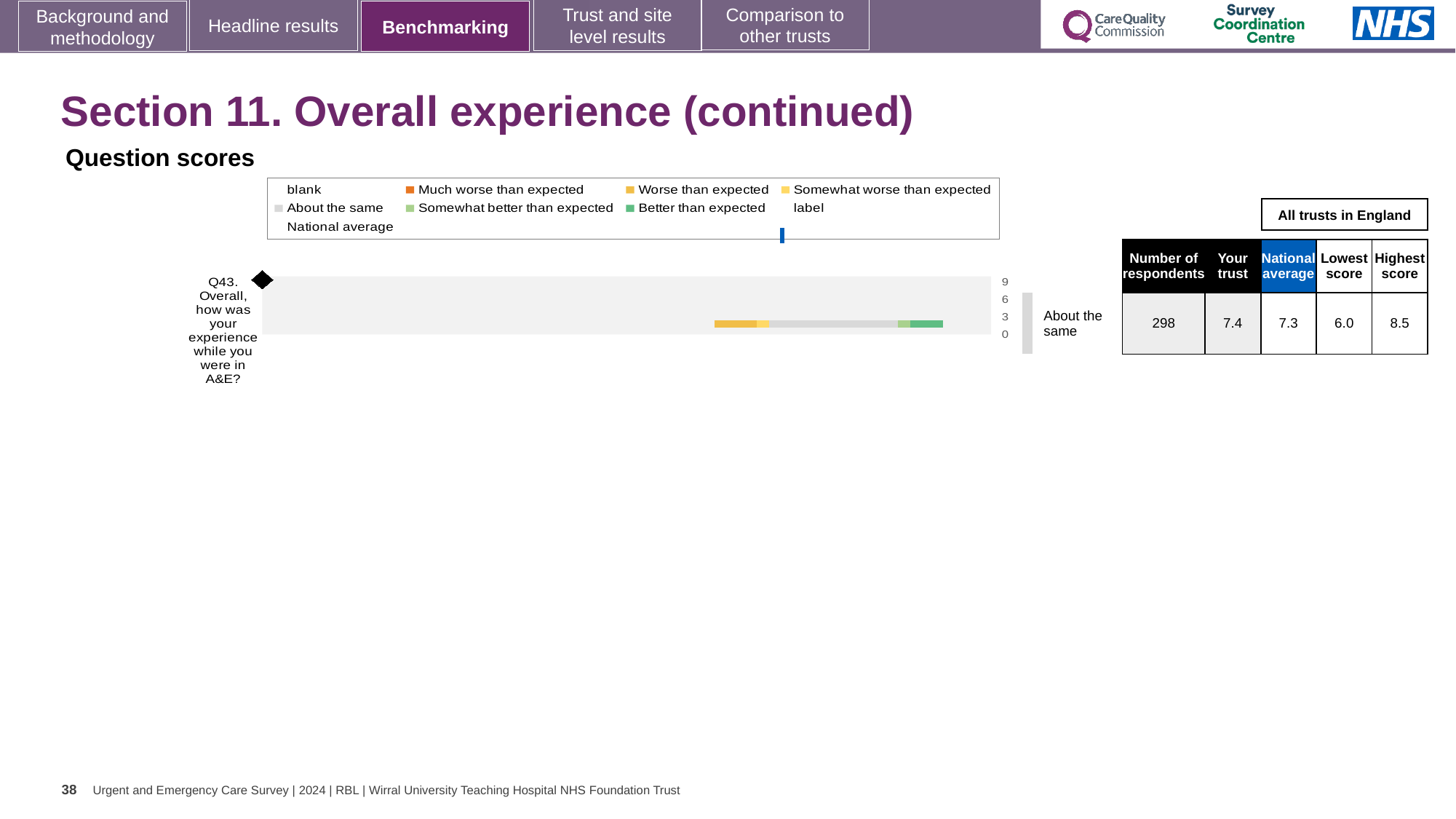
Which benchmarking category is shown next to the bar for Q43? About the same For Q43, which is larger: the 'Your trust' score or the national average? Your trust What is the national average score for Q43? 7.3 How many questions are plotted in the Question scores chart? 1 What is the title of the chart on the slide? Question scores What kind of chart is used to show the Q43 question score? bar chart What is the number of respondents for Q43? 298 For Q43, what is the difference between the highest score and the lowest score among all trusts in England? 2.5 What is the highest score among all trusts in England for Q43? 8.5 Which question is plotted in the Question scores chart? Q43. Overall, how was your experience while you were in A&E? What is the lowest score among all trusts in England for Q43? 6.0 What is the 'Your trust' score for Q43? 7.4